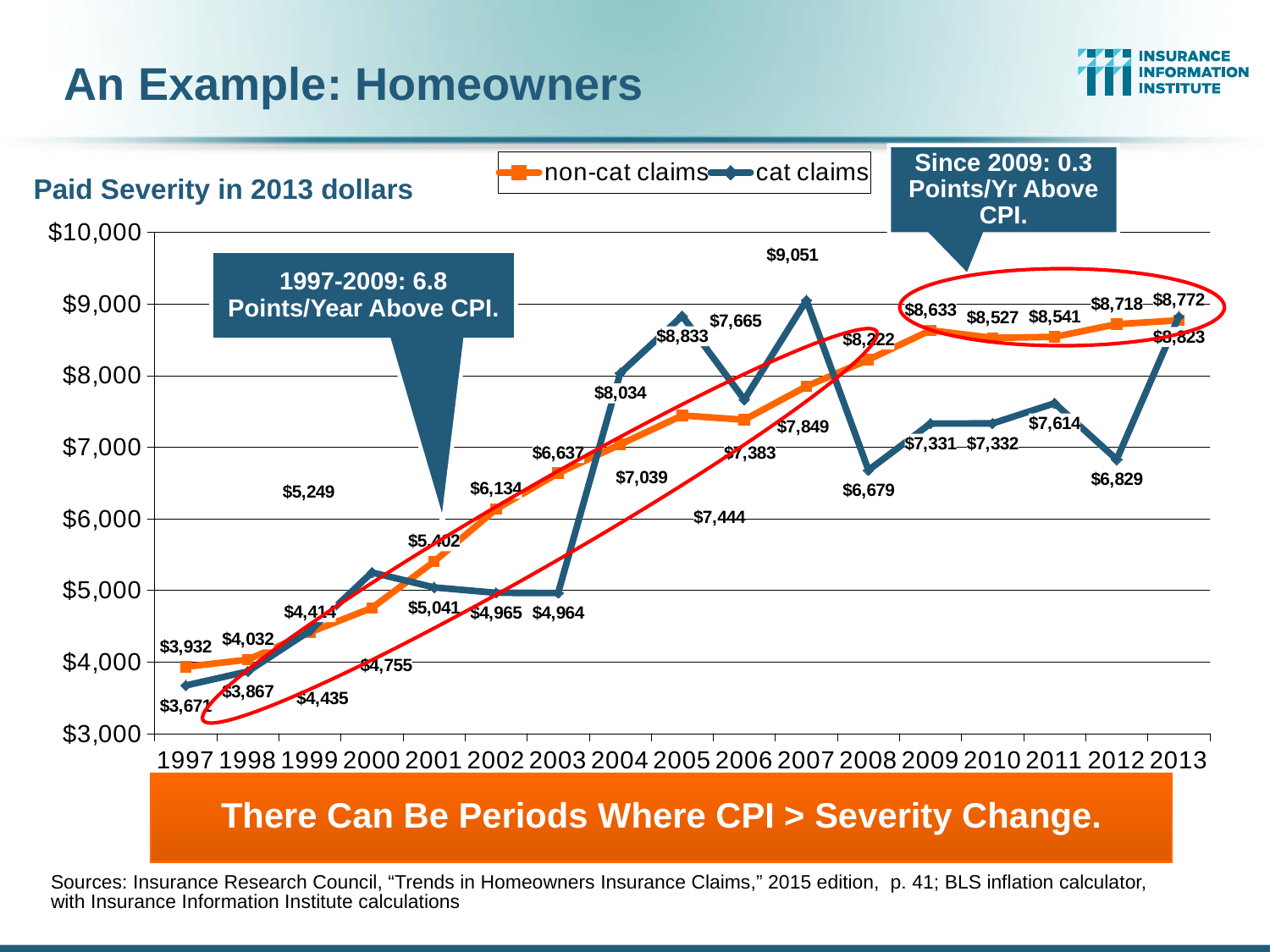
What type of chart is shown on the slide? line chart What is the cat claims paid severity in 2012? $6,829 How many series does the legend list? 2 In 2008, how much higher is the non-cat claims value than the cat claims value? $1,543 In 2007, what is the difference between cat claims and non-cat claims? $1,202 In 2004, which series has the higher value, cat claims or non-cat claims? cat claims In which year is the non-cat claims paid severity lowest? 1997 In which year do cat claims reach their highest paid severity? 2007 How many years are shown on the x axis? 17 What is the cat claims paid severity in 2007? $9,051 What is the non-cat claims paid severity in 2009? $8,633 Do non-cat claims generally rise or fall from 1997 to 2009? rise